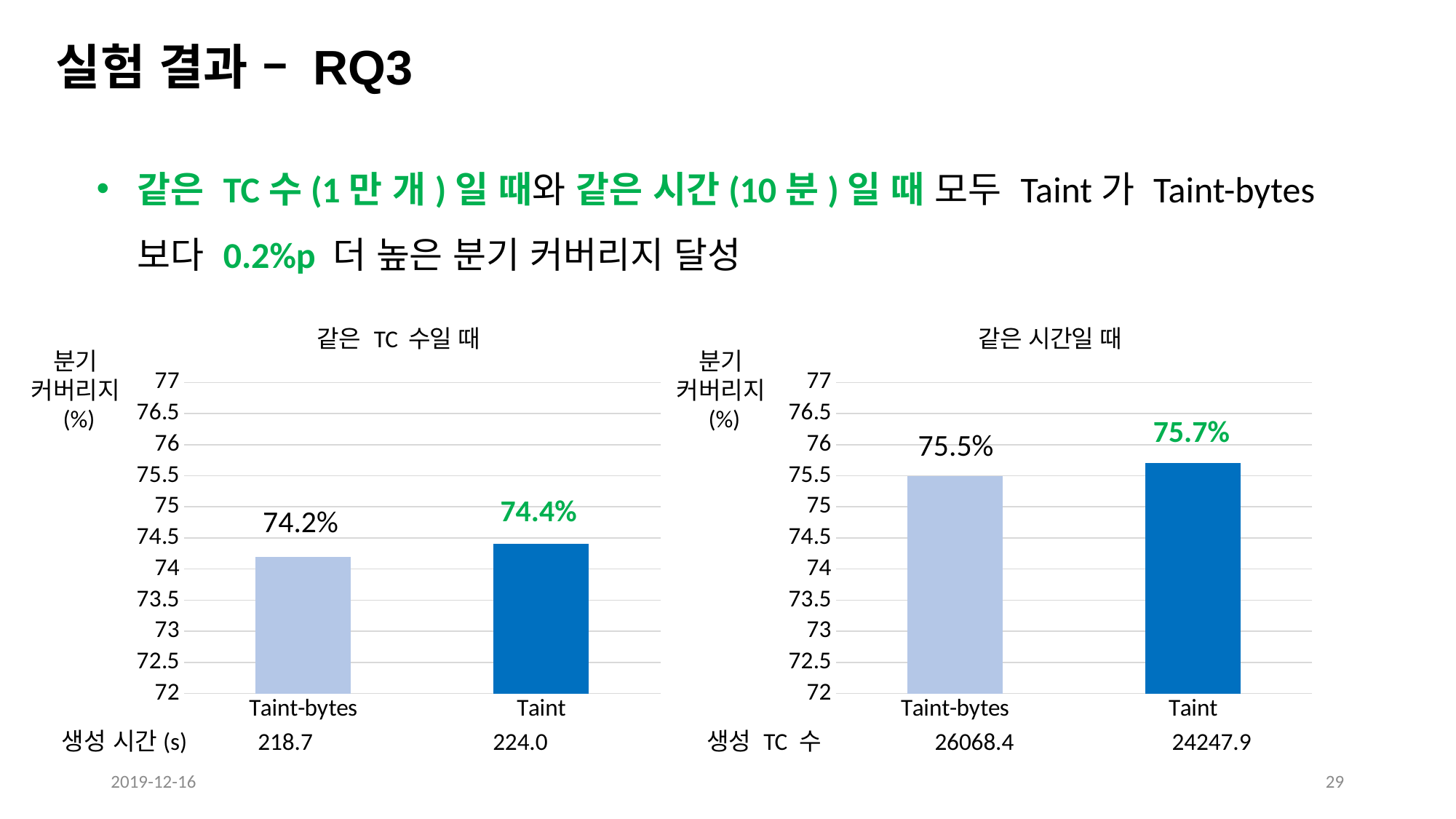
In the left chart (같은 TC 수일 때), which category has the higher branch coverage? Taint In the right chart (같은 시간일 때), what is the branch coverage value for Taint-bytes? 75.5% What kind of chart is the right chart (같은 시간일 때)? Bar chart In the right chart (같은 시간일 때), is the value for Taint-bytes greater or less than 75? greater In the right chart (같은 시간일 때), what is the branch coverage value for Taint? 75.7% In the right chart (같은 시간일 때), which category has the lower branch coverage? Taint-bytes In the left chart (같은 TC 수일 때), what is the difference in branch coverage between Taint and Taint-bytes? 0.2% What is the title of the left chart? 같은 TC 수일 때 In the left chart (같은 TC 수일 때), what is the branch coverage value for Taint? 74.4% In the left chart (같은 TC 수일 때), what is the branch coverage value for Taint-bytes? 74.2% How many categories are shown in the left chart (같은 TC 수일 때)? 2 In the right chart (같은 시간일 때), what is the difference in branch coverage between Taint and Taint-bytes? 0.2%